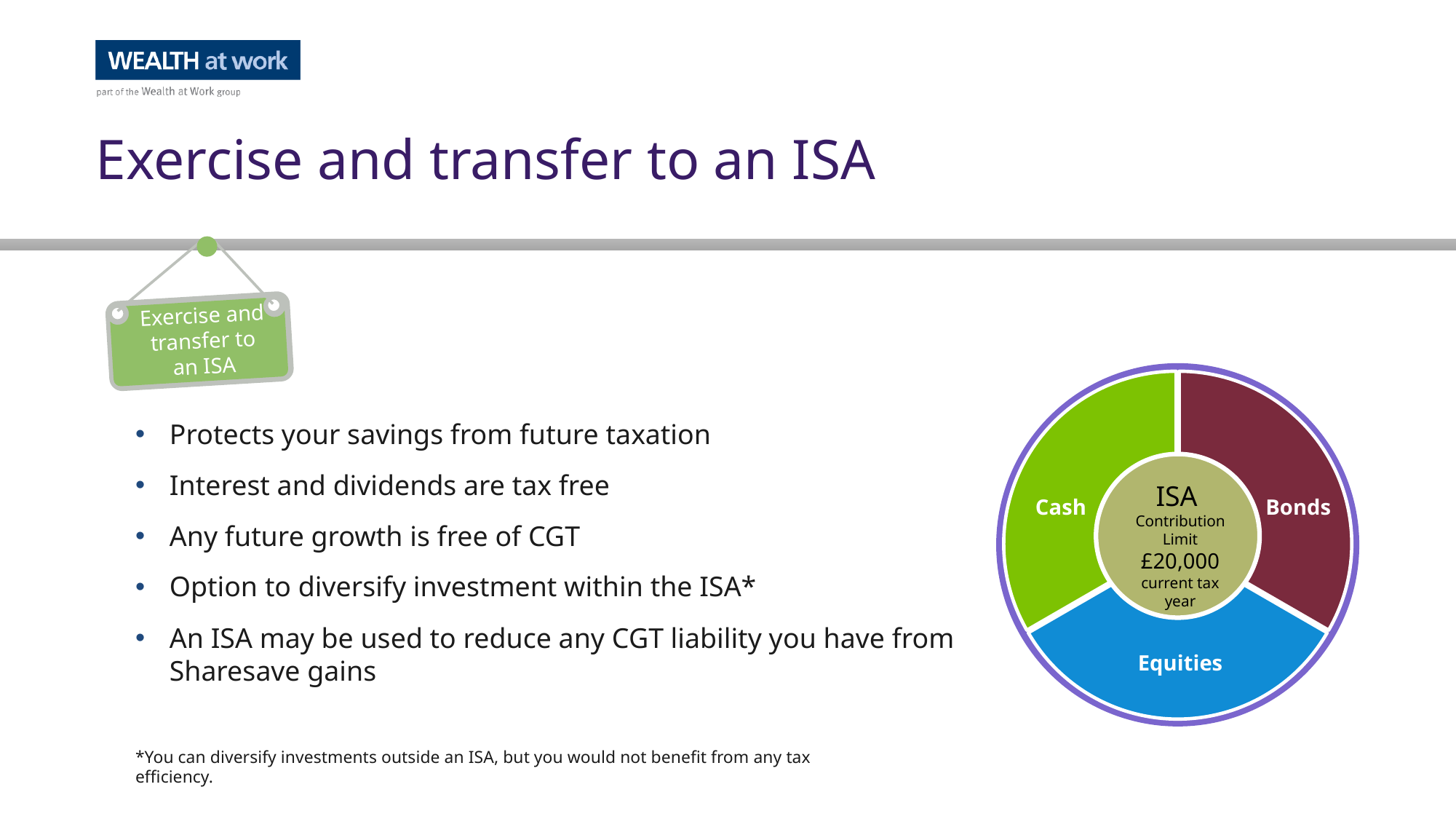
What contribution limit is printed in the centre of the donut chart? £20,000 What are the three segments of the donut chart labelled? Cash, Bonds, Equities Which segment of the donut chart is coloured blue? Equities What kind of chart is shown on the right of the slide? Pie chart (donut) How many segments does the donut chart on the right have? 3